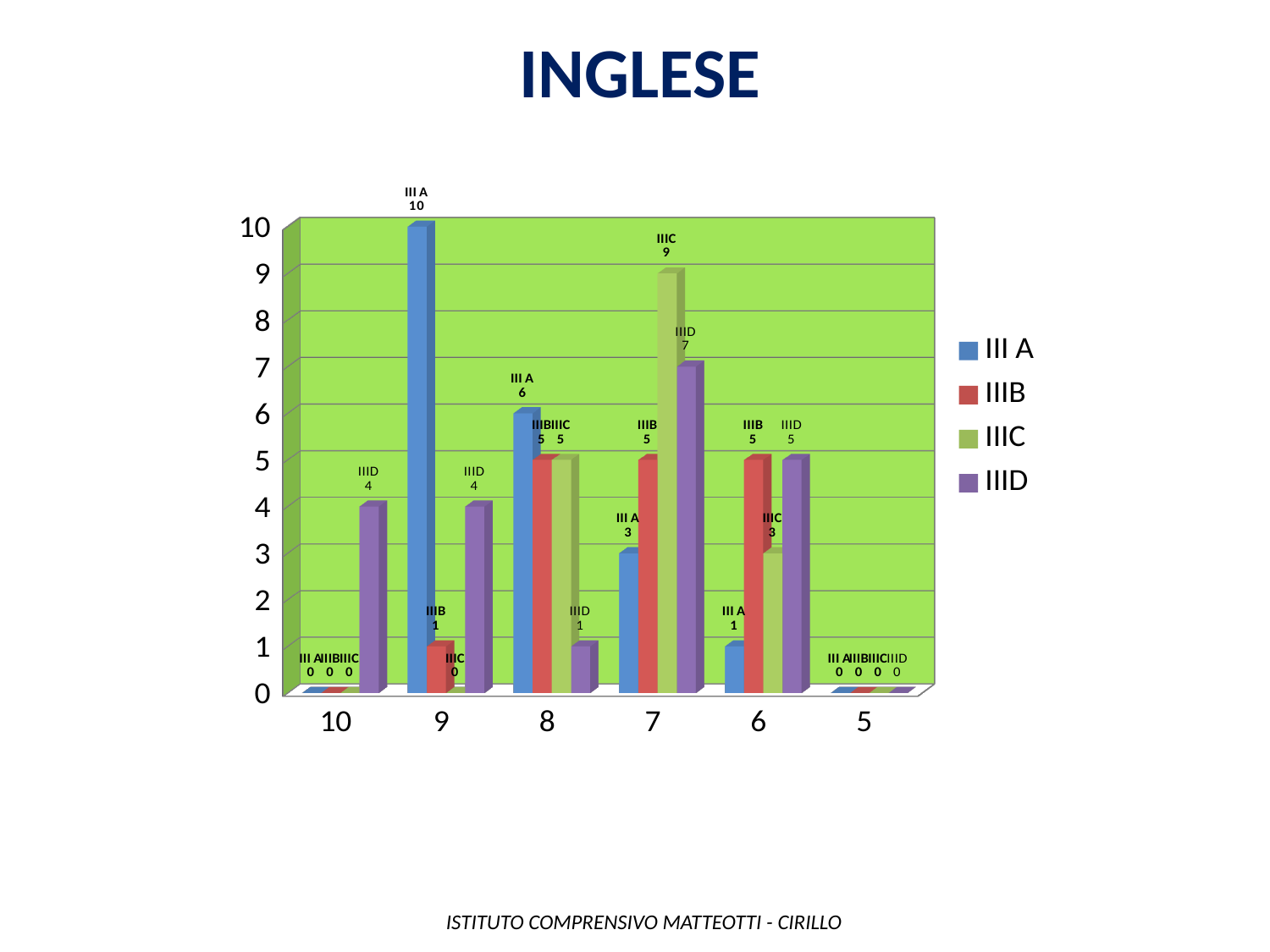
Which is larger: the IIID value at category 7 or the IIID value at category 6? IIID at category 7 What is the value for III A at category 9? 10 What kind of chart is shown on the slide? Bar chart How many categories are shown on the x axis? 6 How many series does the legend list? 4 What is the difference between the III A value at category 9 and the III A value at category 8? 4 Which series has the highest value at category 7? IIIC What is the value for IIIC at category 7? 9 What is the value for IIID at category 10? 4 Which series has the lowest value at category 8? IIID What is the value for IIIB at category 6? 5 What is the title of the chart? INGLESE